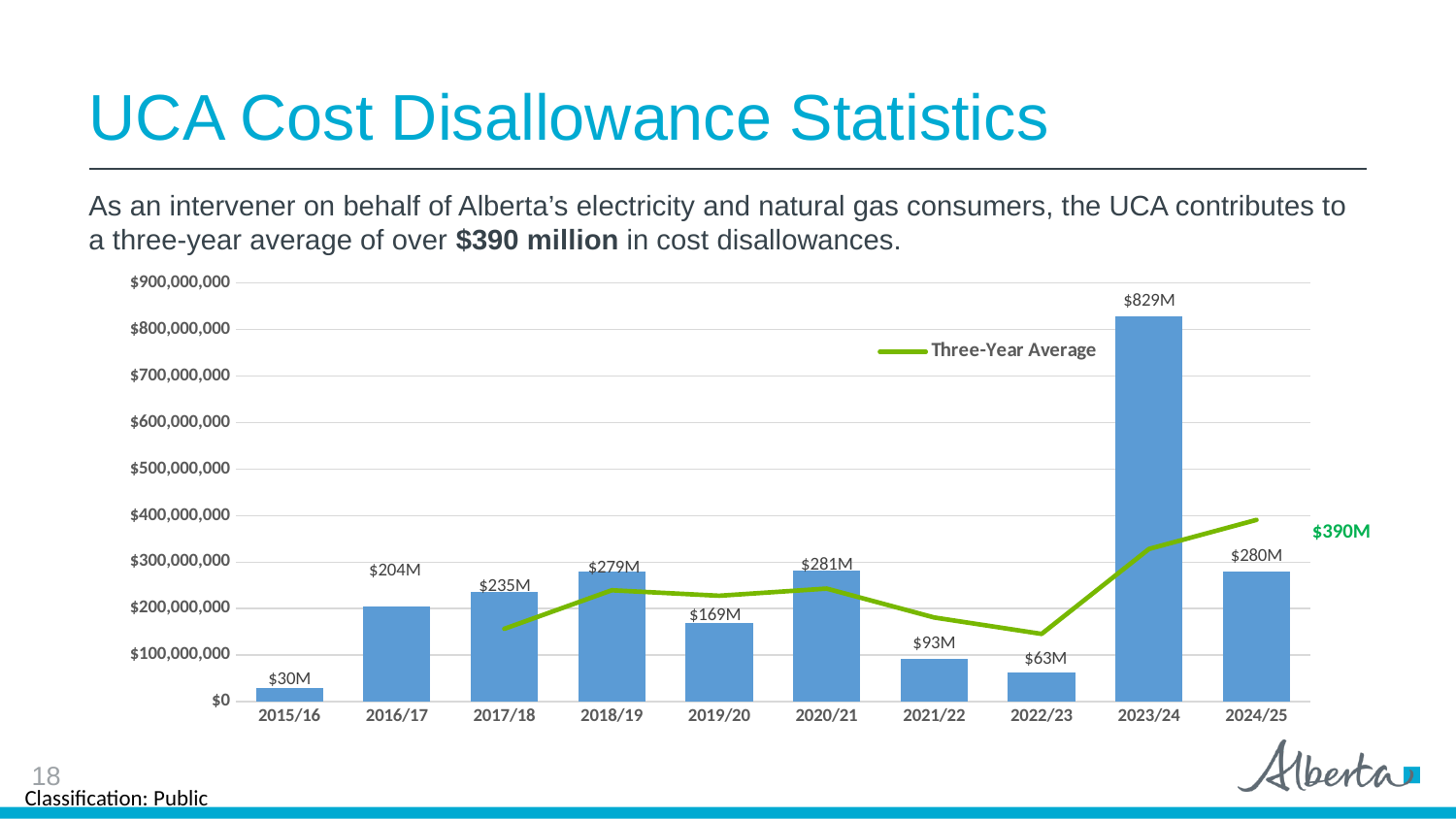
What is the cost disallowance value for 2023/24? $829M Which year has the lowest cost disallowance value? 2015/16 How many years are shown on the x axis? 10 Do the bar values rise or fall from 2020/21 to 2022/23? fall How many series does the legend list? 1 What is the cost disallowance value for 2015/16? $30M What is the difference between the 2023/24 value and the 2024/25 value? $549M What is the cost disallowance value for 2019/20? $169M What kind of chart is used to show the yearly cost disallowance values? bar chart Which is larger, the value for 2016/17 or the value for 2021/22? 2016/17 Which year has the highest cost disallowance value? 2023/24 Is the value for 2021/22 greater or less than $100,000,000? less